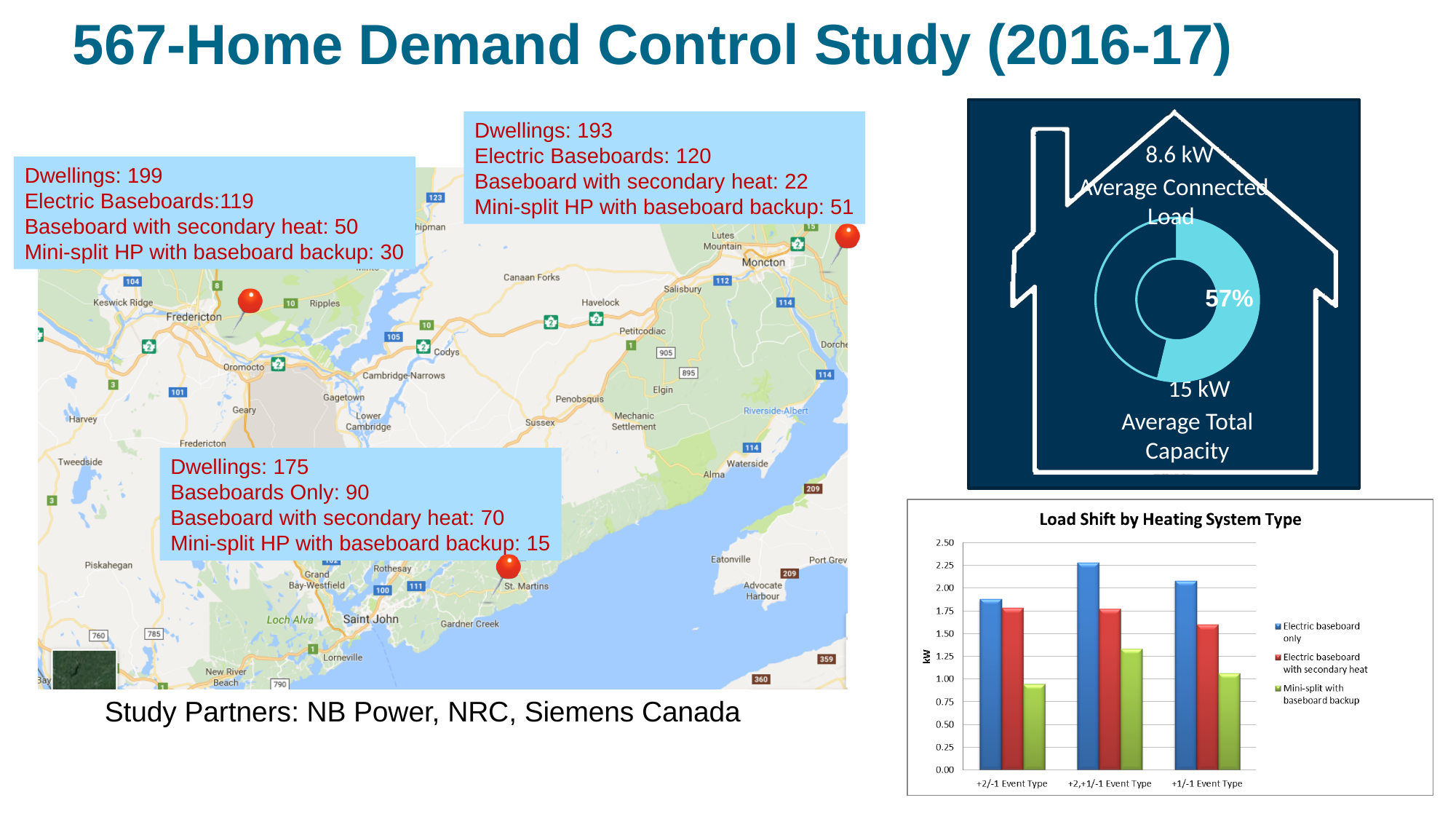
In the 'Load Shift by Heating System Type' chart, is the value for Mini-split with baseboard backup at +2/-1 Event Type greater or less than 1.00? less In the donut chart inside the house graphic, what percentage is shown for the highlighted slice? 57% In the 'Load Shift by Heating System Type' chart, is the value for Electric baseboard with secondary heat at +1/-1 Event Type greater or less than 1.75? less In the 'Load Shift by Heating System Type' chart, which event type has the highest value for Electric baseboard only? +2,+1/-1 Event Type In the 'Load Shift by Heating System Type' chart, which event type has the lowest value for Mini-split with baseboard backup? +2/-1 Event Type What is the title of the bar chart at the bottom right of the slide? Load Shift by Heating System Type In the 'Load Shift by Heating System Type' chart, is the value for Electric baseboard only at +2,+1/-1 Event Type greater or less than 2.00? greater How many event type categories are shown on the x axis of the 'Load Shift by Heating System Type' chart? 3 In the 'Load Shift by Heating System Type' chart, for +2/-1 Event Type, which is larger: Electric baseboard only or Mini-split with baseboard backup? Electric baseboard only How many series does the legend of the 'Load Shift by Heating System Type' chart list? 3 In the 'Load Shift by Heating System Type' chart, which is larger for Electric baseboard only: +2,+1/-1 Event Type or +1/-1 Event Type? +2,+1/-1 Event Type What kind of chart is the 'Load Shift by Heating System Type' chart? bar chart